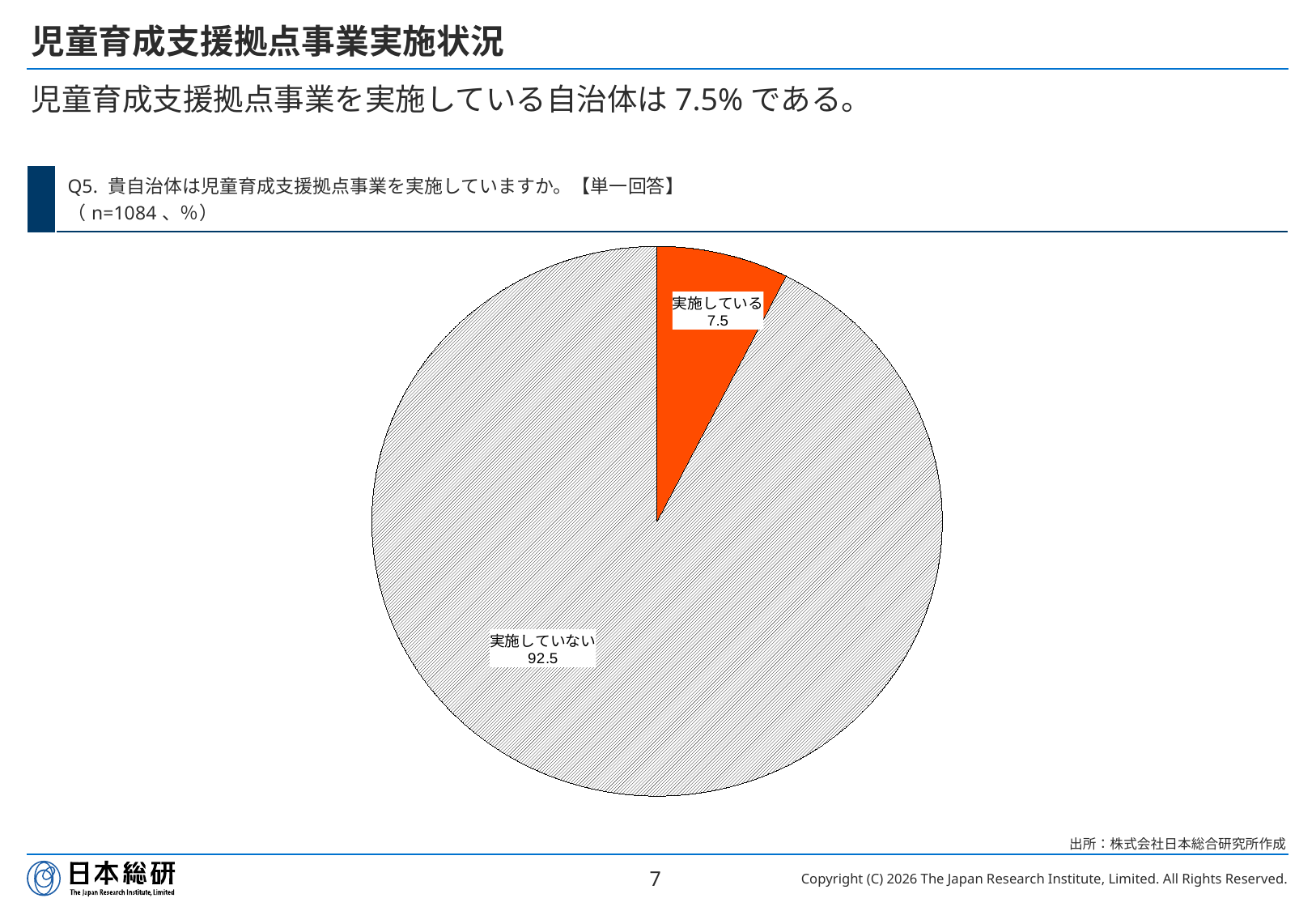
Which is larger, 実施している or 実施していない? 実施していない What is the sample size (n) stated for the chart? 1084 What is the value for 実施していない? 92.5 What is the difference between the values for 実施していない and 実施している? 85.0 Which slice is the smallest? 実施している What kind of chart is shown on the slide? pie chart What share of the pie does 実施している represent? 7.5% What colour is the 実施している slice? orange How many slices does the pie chart have? 2 Which slice is the largest? 実施していない What is the value for 実施している? 7.5